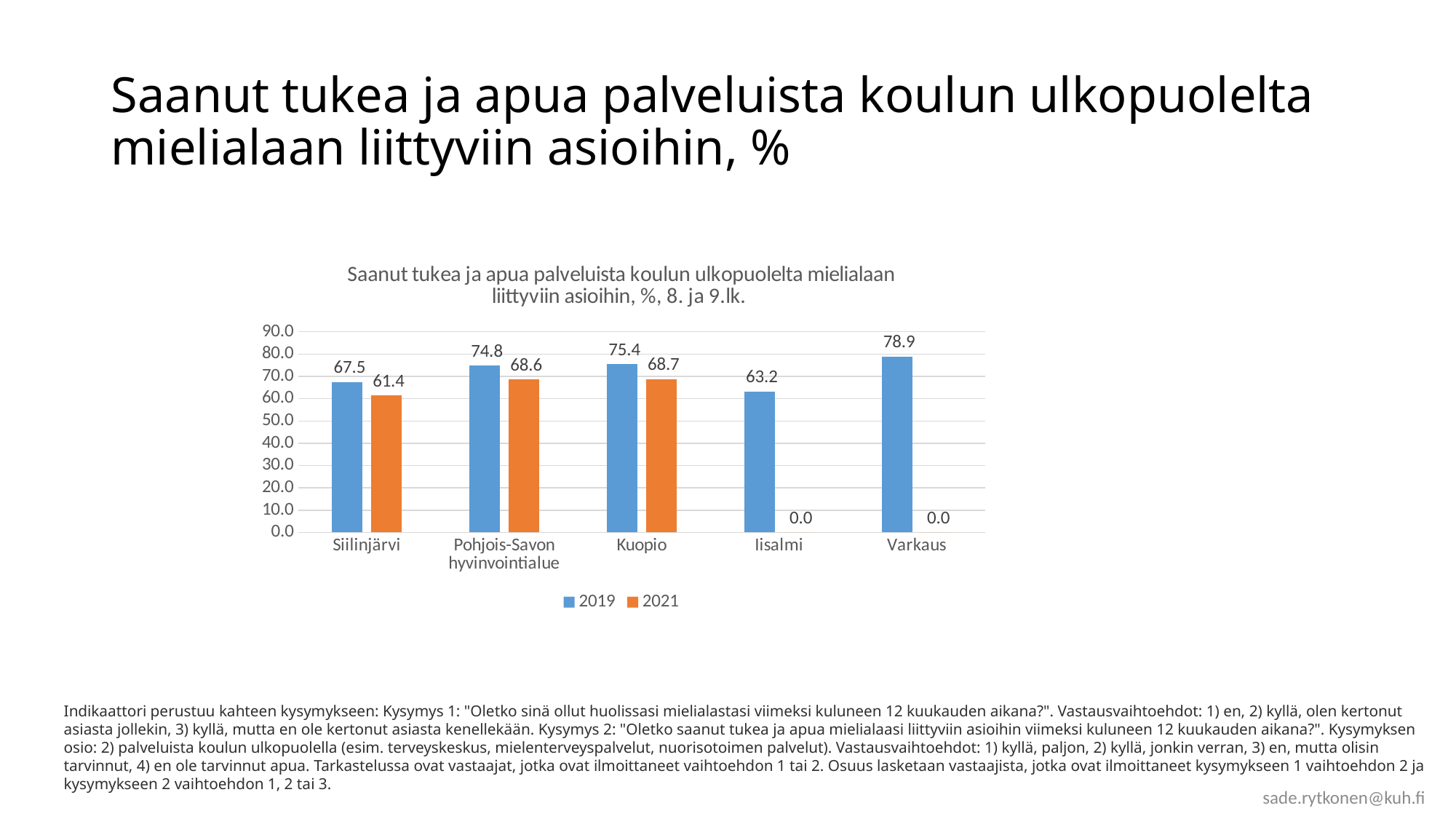
What is the 2021 value for Pohjois-Savon hyvinvointialue? 68.6 How many series does the legend list? 2 Which is larger, the 2019 value for Kuopio or the 2019 value for Pohjois-Savon hyvinvointialue? Kuopio Which colour represents the 2021 series in the legend? Orange Which category has the highest 2019 value? Varkaus What is the 2019 value for Iisalmi? 63.2 Which category has the lowest 2019 value? Iisalmi What is the difference between the 2019 and 2021 values for Siilinjärvi? 6.1 What kind of chart is shown on the slide? Bar chart What is the 2021 value for Kuopio? 68.7 How many categories are shown on the x axis? 5 What is the 2019 value for Siilinjärvi? 67.5